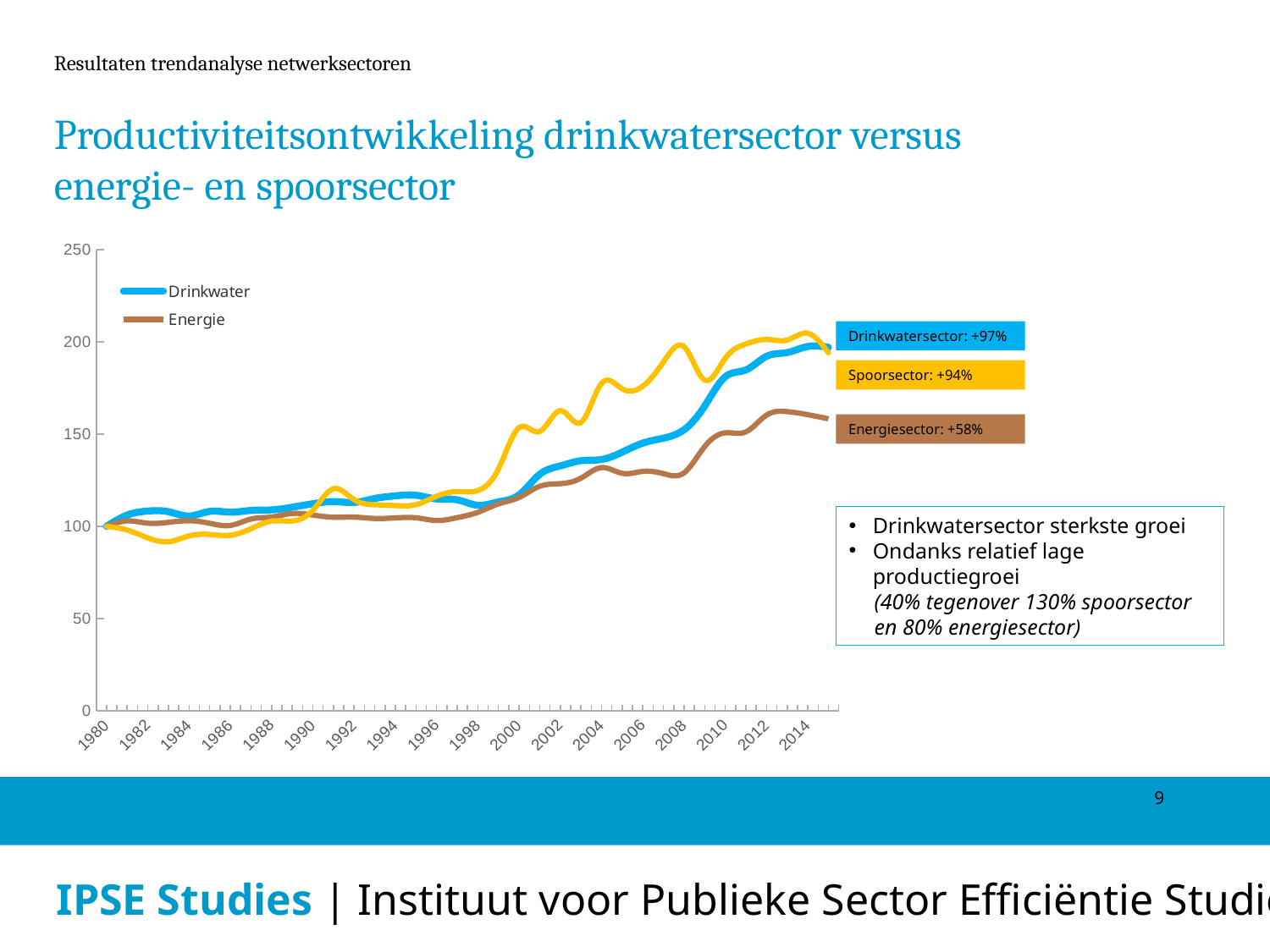
In 2014, which line is higher: Drinkwater or Energie? Drinkwater According to the annotation on the chart, what is the growth of the Energiesector? +58% Which two series are named in the chart legend? Drinkwater and Energie What is the first year shown on the x axis? 1980 What kind of chart is shown on the slide? line chart Does the Drinkwater line rise or fall overall from 1980 to 2014? rise How many series does the chart legend list? 2 According to the annotation on the chart, what is the growth of the Spoorsector? +94% According to the annotation on the chart, what is the growth of the Drinkwatersector? +97% Is the value of the Energie line in 2014 greater or less than 150? greater Is the value of the Drinkwater line in 2014 greater or less than 150? greater Which sector has the lowest growth according to the annotations on the chart? Energiesector